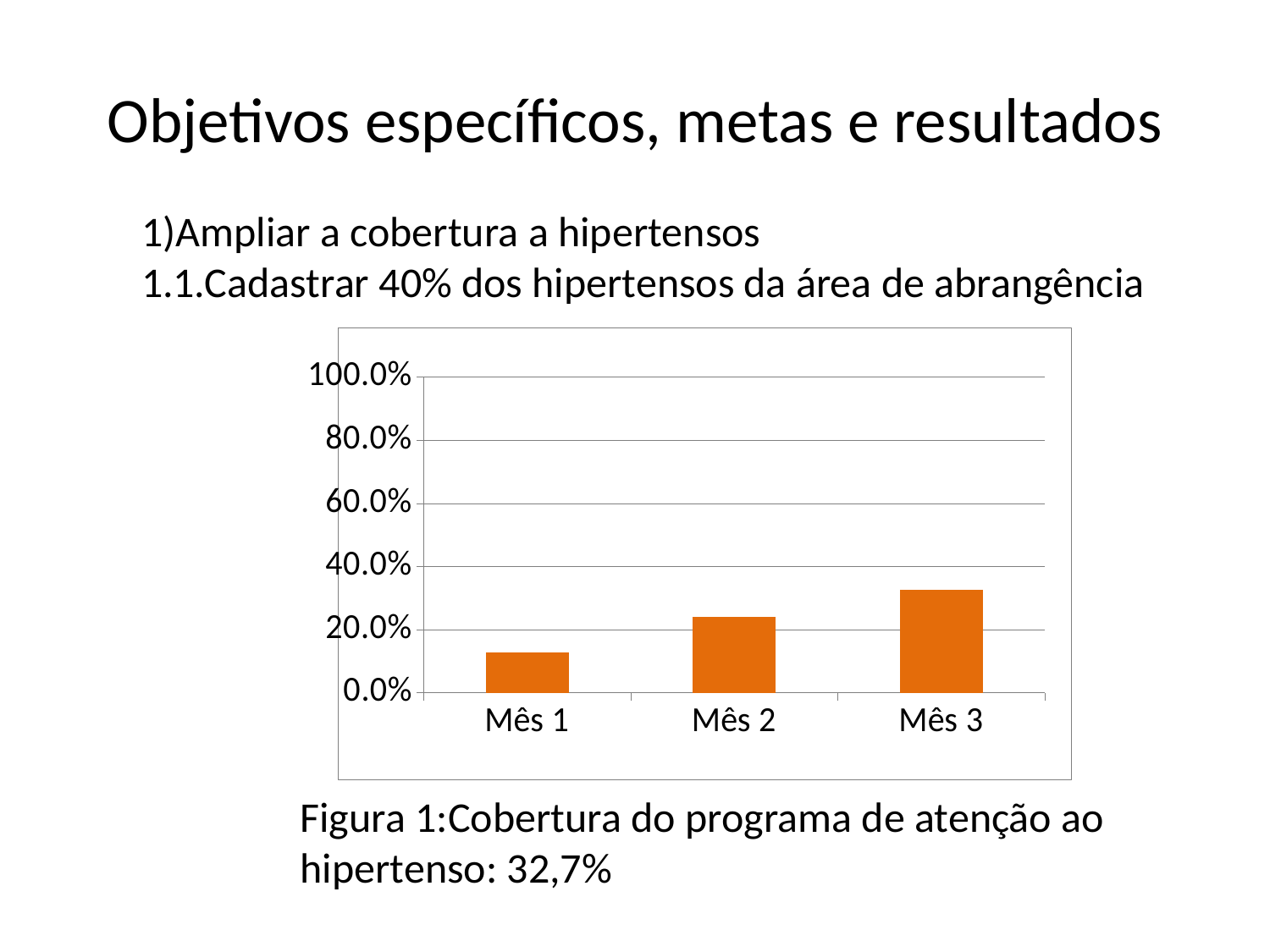
Is the value for Mês 2 greater or less than 20.0%? greater Which month has the lowest bar on the chart? Mês 1 What colour are the bars on the chart? orange Which month has the highest bar on the chart? Mês 3 Do the values rise or fall from Mês 1 to Mês 3? rise What is the highest value shown on the chart's vertical axis? 100.0% How many categories (months) are plotted on the chart? 3 What kind of chart is shown on the slide? bar chart Is the value for Mês 3 greater or less than 20.0%? greater Is the value for Mês 3 greater or less than 40.0%? less Which is larger, the value for Mês 1 or the value for Mês 2? Mês 2